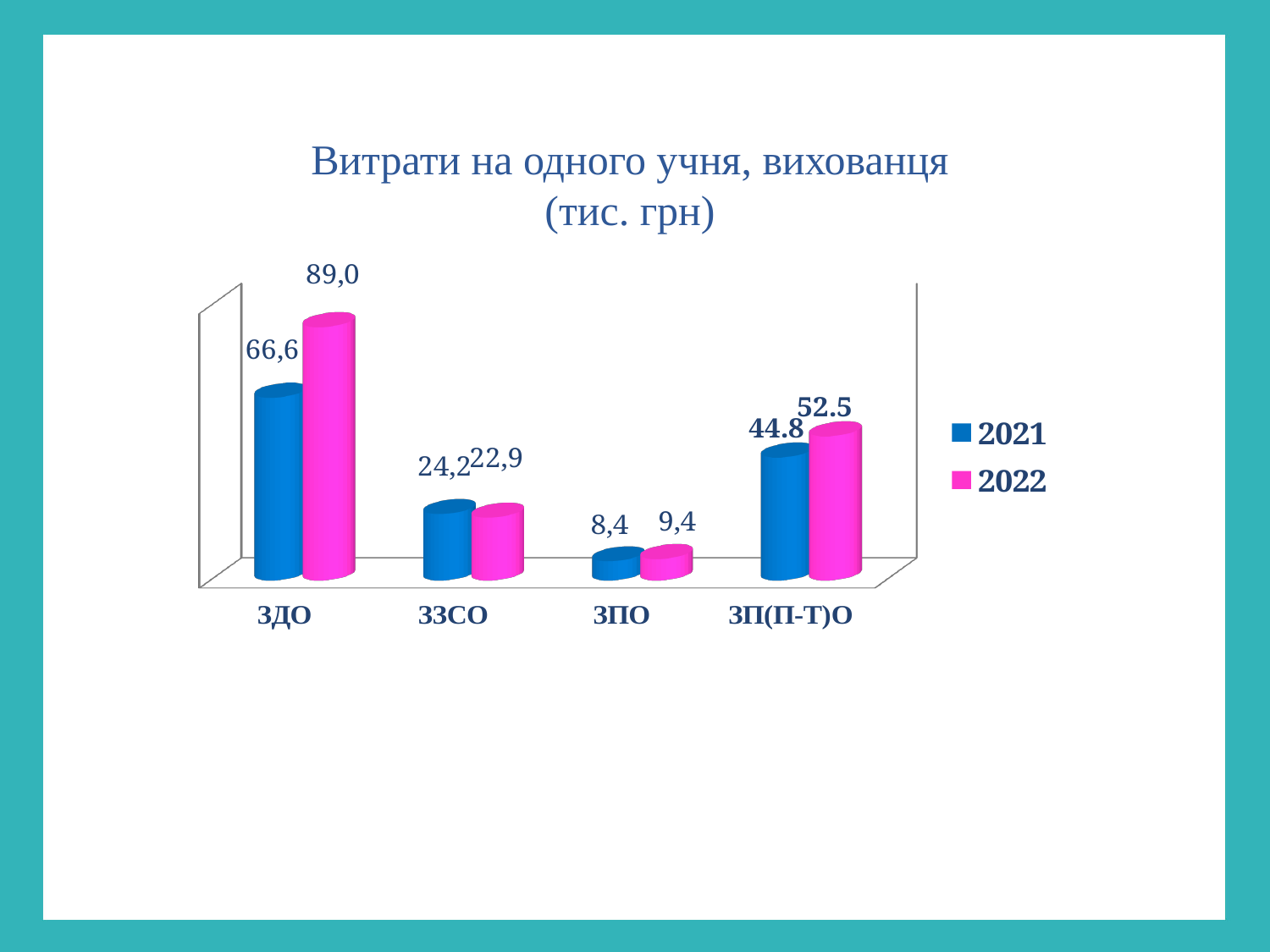
How many categories are shown on the x axis? 4 What is the value for ЗЗСО in the 2021 series? 24,2 Which category has the lowest value in the 2021 series? ЗПО Which is larger for ЗЗСО: the 2021 value or the 2022 value? 2021 How many series does the legend list? 2 What kind of chart is shown on the slide? Bar chart What is the value for ЗП(П-Т)О in the 2022 series? 52.5 What is the value for ЗДО in the 2022 series? 89,0 What is the difference between the 2022 and 2021 values for ЗП(П-Т)О? 7.7 What is the difference between the 2022 and 2021 values for ЗДО? 22,4 Which category has the highest value in the 2022 series? ЗДО What is the value for ЗПО in the 2021 series? 8,4